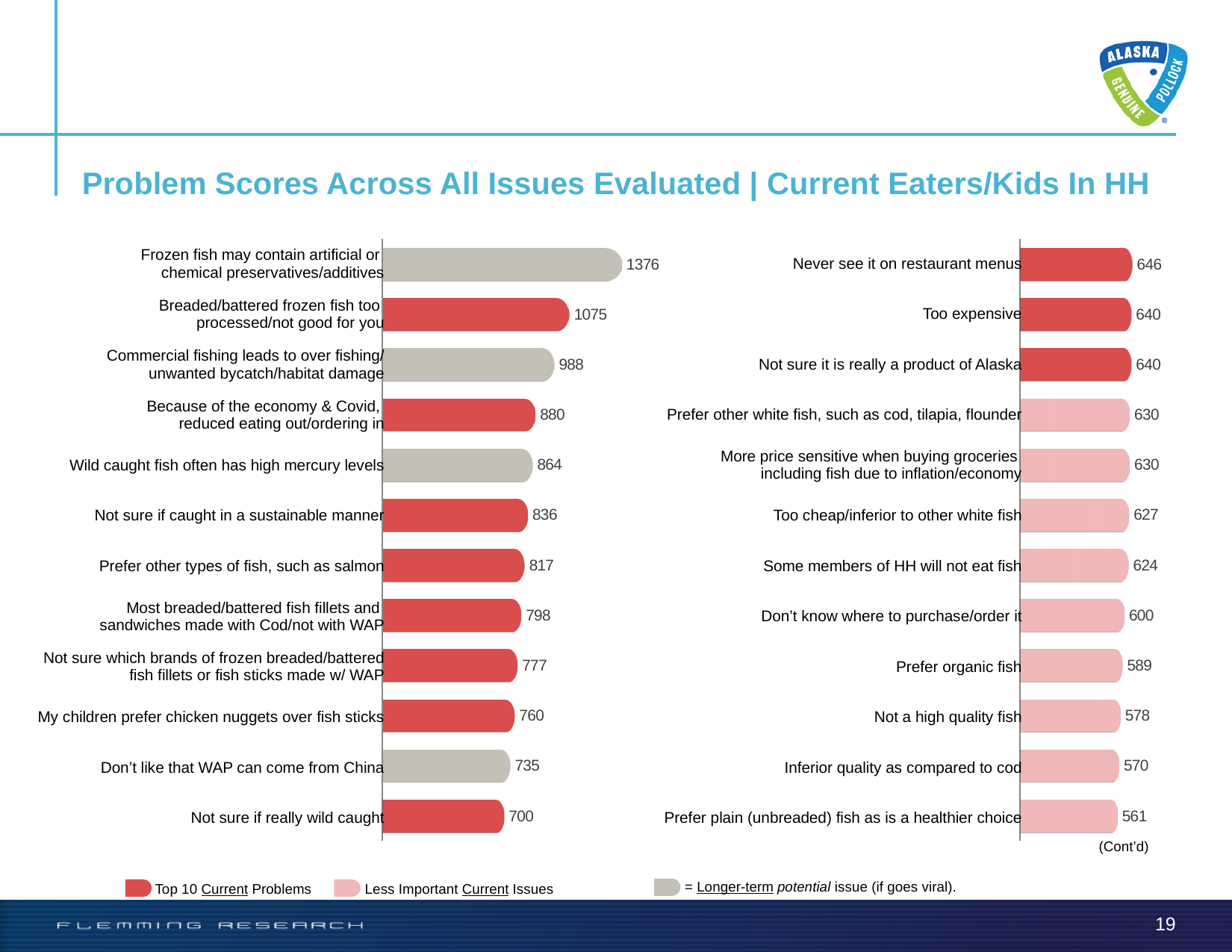
In the right chart, what is the difference between the scores for "Never see it on restaurant menus" and "Don't know where to purchase/order it"? 46 In the right chart, which has a higher score: "Too cheap/inferior to other white fish" or "Not a high quality fish"? Too cheap/inferior to other white fish In the right chart, what is the problem score for "Some members of HH will not eat fish"? 624 In the right chart, which issue has the lowest problem score? Prefer plain (unbreaded) fish as is a healthier choice How many issues are plotted in the right chart? 12 In the left chart, which issue has the highest problem score? Frozen fish may contain artificial or chemical preservatives/additives How many issues are plotted in the left chart? 12 In the left chart, what is the problem score for "Wild caught fish often has high mercury levels"? 864 What type of chart is used on this slide? Bar chart In the left chart, which has a higher score: "Because of the economy & Covid, reduced eating out/ordering in" or "My children prefer chicken nuggets over fish sticks"? Because of the economy & Covid, reduced eating out/ordering in In the left chart, what is the difference between the scores for "Breaded/battered frozen fish too processed/not good for you" and "Not sure if really wild caught"? 375 How many categories does the legend at the bottom of the slide list? 3